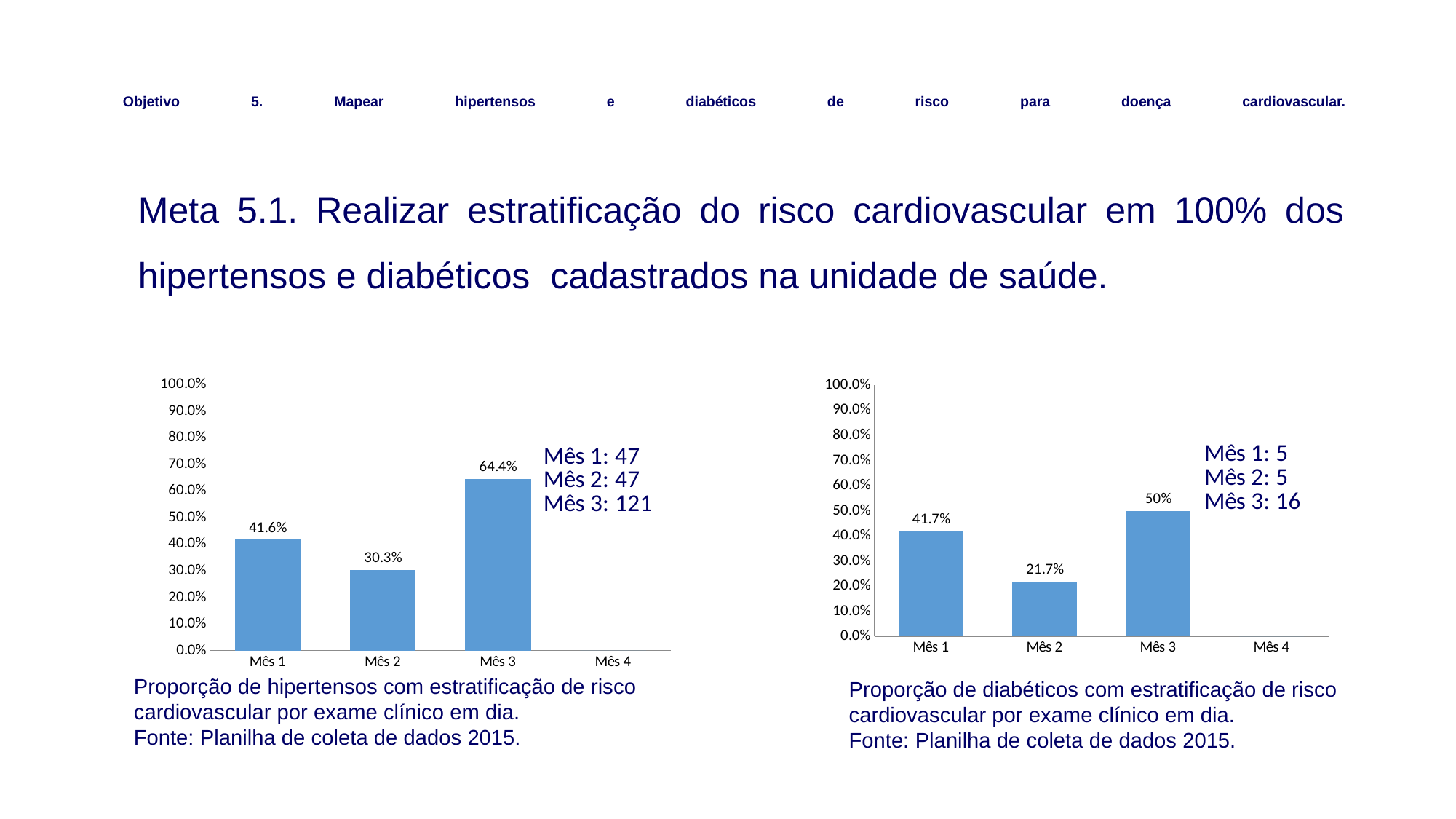
In the right chart (Proporção de diabéticos), is the value for Mês 3 greater or less than 40.0%? greater How many month categories are shown on the x axis of the left chart (Proporção de hipertensos)? 4 In the right chart (Proporção de diabéticos), which month has the lowest value among the plotted bars? Mês 2 In the right chart (Proporção de diabéticos), what is the value for Mês 3? 50% In the left chart (Proporção de hipertensos), what is the value for Mês 3? 64.4% In the right chart (Proporção de diabéticos), what is the difference between the values for Mês 1 and Mês 2? 20.0 percentage points In the left chart (Proporção de hipertensos), which month has the highest value? Mês 3 In the right chart (Proporção de diabéticos), what is the value for Mês 1? 41.7% In the left chart (Proporção de hipertensos), which is larger, the value for Mês 1 or Mês 2? Mês 1 In the left chart (Proporção de hipertensos), what is the value for Mês 2? 30.3% What kind of chart is the right chart (Proporção de diabéticos)? bar chart In the left chart (Proporção de hipertensos), what is the difference between the values for Mês 3 and Mês 1? 22.8 percentage points